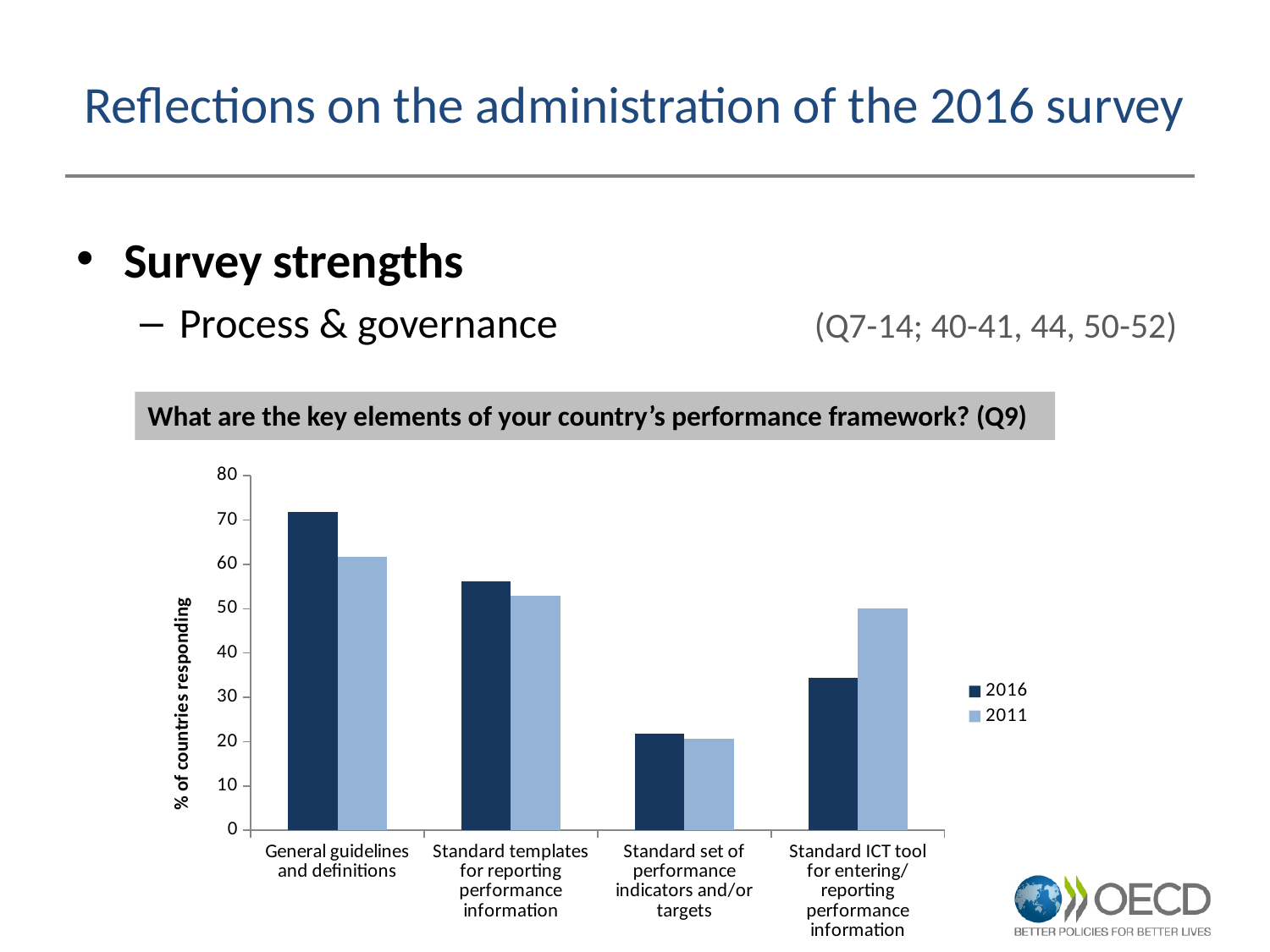
What kind of chart is shown on the slide? bar chart How many series does the chart legend list? 2 Which category has the lowest value for 2016? Standard set of performance indicators and/or targets For Standard ICT tool for entering/reporting performance information, which is larger: the 2016 value or the 2011 value? 2011 Is the 2016 value for Standard ICT tool for entering/reporting performance information greater or less than 40? less Is the 2011 value for Standard ICT tool for entering/reporting performance information greater or less than 40? greater Which category has the highest value for 2011? General guidelines and definitions Which category has the highest value for 2016? General guidelines and definitions Is the 2016 value for General guidelines and definitions greater or less than 60? greater What is the label of the vertical axis of the chart? % of countries responding For General guidelines and definitions, which is larger: the 2016 value or the 2011 value? 2016 How many categories are shown on the x axis of the chart? 4